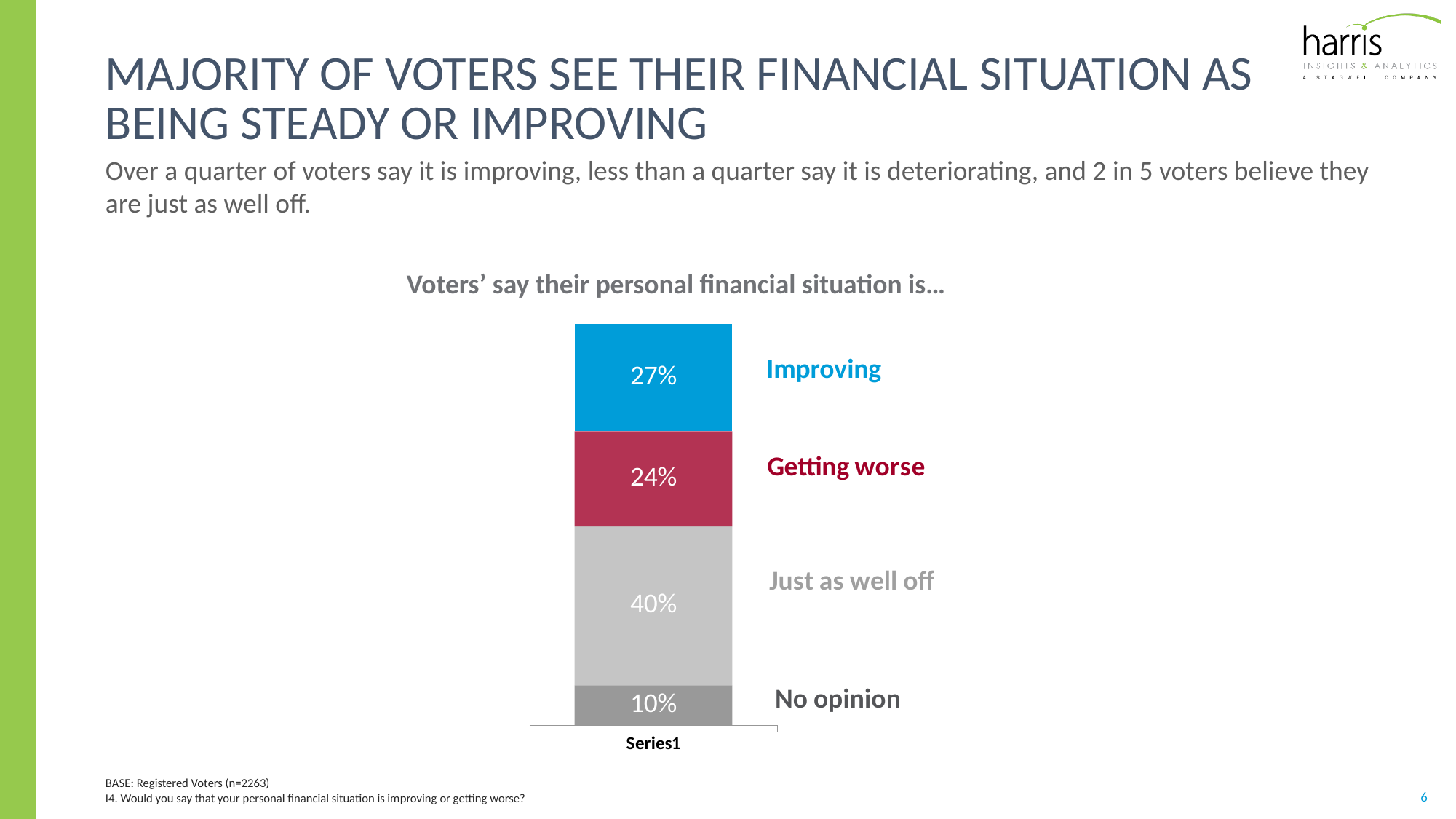
What percentage of voters have no opinion on their personal financial situation? 10% Which response has the smallest share of voters? No opinion What percentage of voters say they are just as well off? 40% What is the difference in percentage points between 'Just as well off' and 'No opinion'? 30 What type of chart is shown on the slide? Stacked bar chart What percentage of voters say their personal financial situation is getting worse? 24% What percentage of voters say their personal financial situation is improving? 27% How many response categories are shown in the stacked bar? 4 Which is larger, the share saying 'Improving' or the share saying 'Getting worse'? Improving What is the difference in percentage points between 'Improving' and 'Getting worse'? 3 Which response has the largest share of voters? Just as well off What is the title of the chart? Voters' say their personal financial situation is...